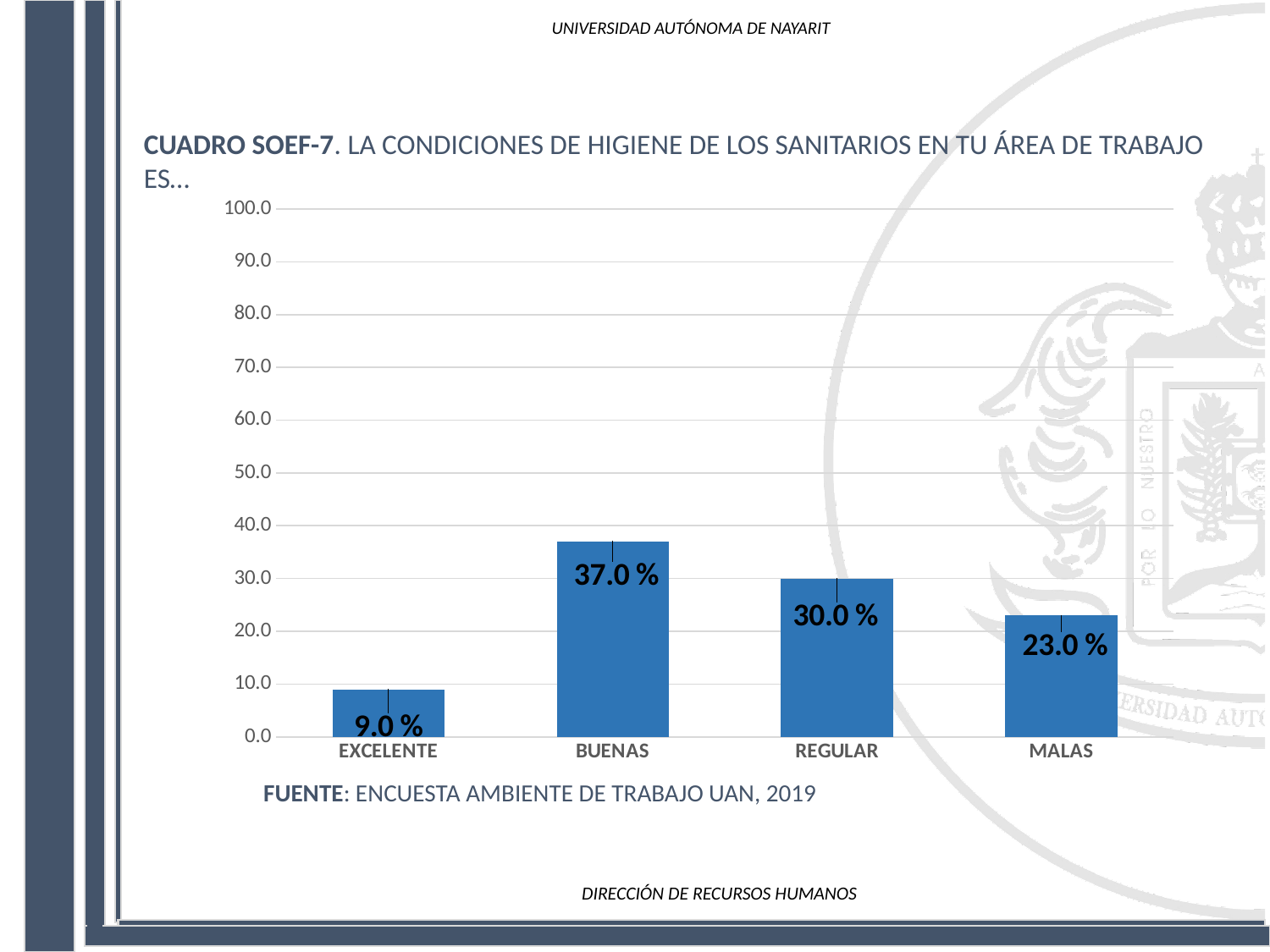
What is the value for MALAS? 23.0 % Which category has the lowest value? EXCELENTE What is the value for EXCELENTE? 9.0 % What source is cited below the chart? ENCUESTA AMBIENTE DE TRABAJO UAN, 2019 How many categories are shown on the x axis? 4 What is the difference between the values for BUENAS and REGULAR? 7.0 % What kind of chart is shown on the slide? bar chart What is the total of the values for EXCELENTE and MALAS? 32.0 % Which is larger, the value for REGULAR or the value for MALAS? REGULAR Which category has the highest value? BUENAS Is the value for REGULAR greater or less than 20.0? greater What is the value for BUENAS? 37.0 %